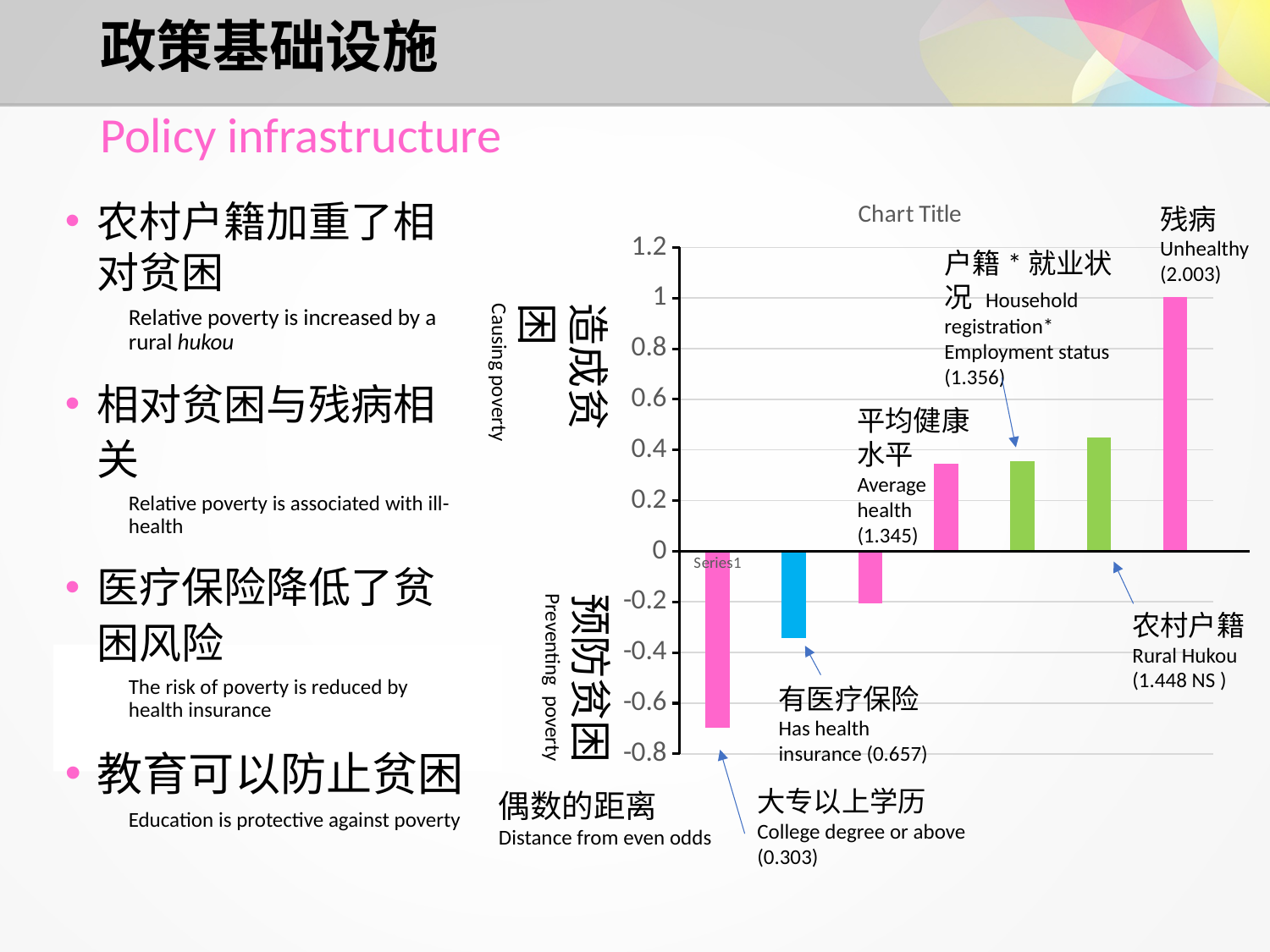
Is the value for the College degree or above bar greater or less than -0.6? less What kind of chart is shown on the slide? bar chart Which labelled bar reaches the lowest (most negative) value in the chart? College degree or above What colour is the Has health insurance bar? blue How many bars in the chart extend below zero? 3 Is the value for the Household registration * Employment status bar greater or less than 0.2? greater Which bar is taller, Unhealthy or Rural Hukou? Unhealthy Is the value for the Unhealthy bar greater or less than 0.8? greater Which labelled bar reaches the highest value in the chart? Unhealthy How many bars are plotted in the chart? 7 What is the title shown above the chart? Chart Title